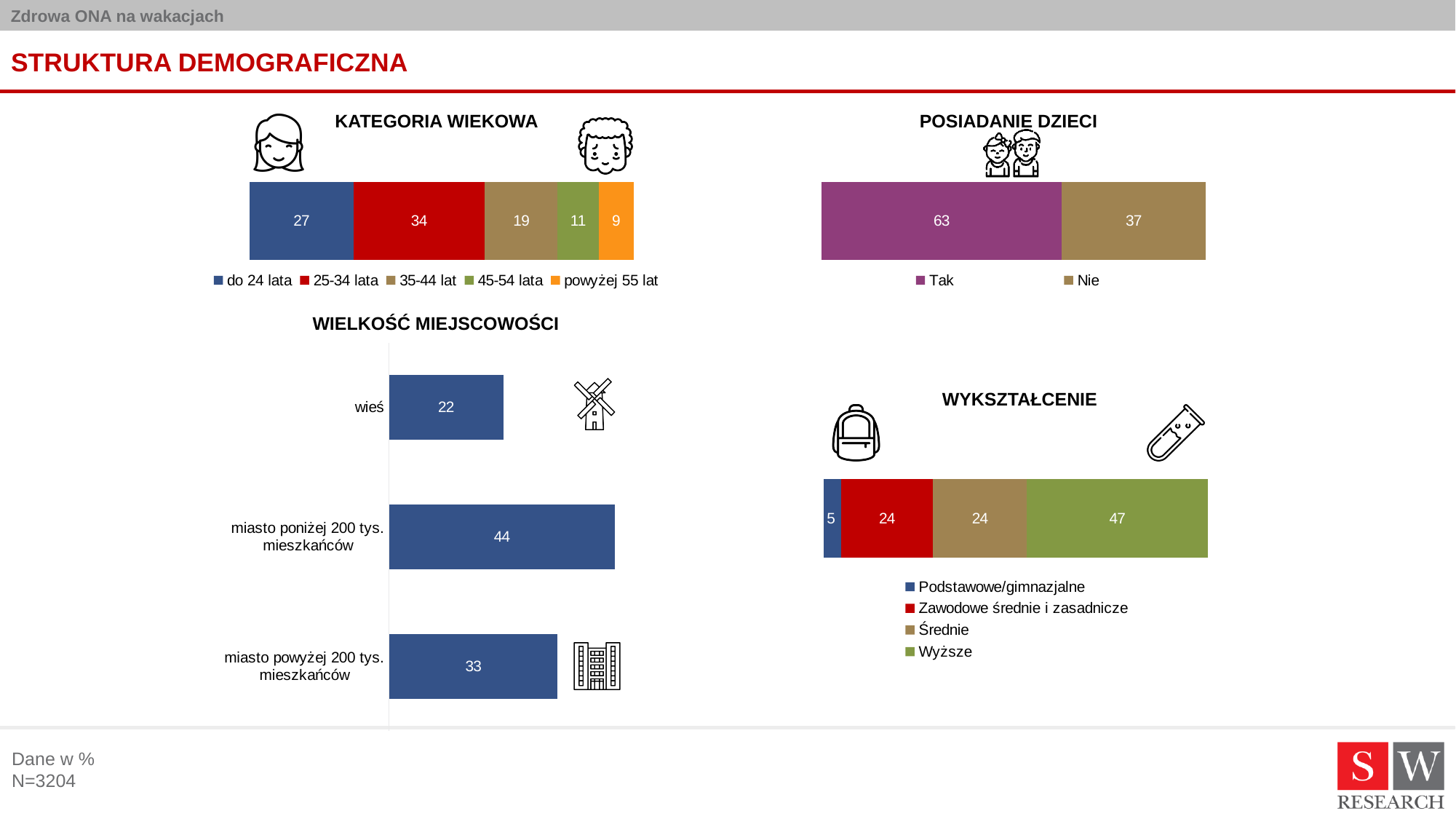
In the KATEGORIA WIEKOWA chart, which age category has the lowest value? powyżej 55 lat In the KATEGORIA WIEKOWA chart, what is the difference between the values for 25-34 lata and 35-44 lat? 15 In the KATEGORIA WIEKOWA chart, what is the value for 25-34 lata? 34 In the POSIADANIE DZIECI chart, what is the value for Tak? 63 In the KATEGORIA WIEKOWA chart, how many series does the legend list? 5 In the WYKSZTAŁCENIE chart, what is the difference between the values for Wyższe and Podstawowe/gimnazjalne? 42 In the POSIADANIE DZIECI chart, which is larger, Tak or Nie? Tak In the WIELKOŚĆ MIEJSCOWOŚCI chart, which category has the highest value? miasto poniżej 200 tys. mieszkańców In the WYKSZTAŁCENIE chart, what is the value for Wyższe? 47 In the WIELKOŚĆ MIEJSCOWOŚCI chart, how many categories are shown? 3 In the WIELKOŚĆ MIEJSCOWOŚCI chart, what is the value for wieś? 22 What kind of chart is the WIELKOŚĆ MIEJSCOWOŚCI chart? bar chart